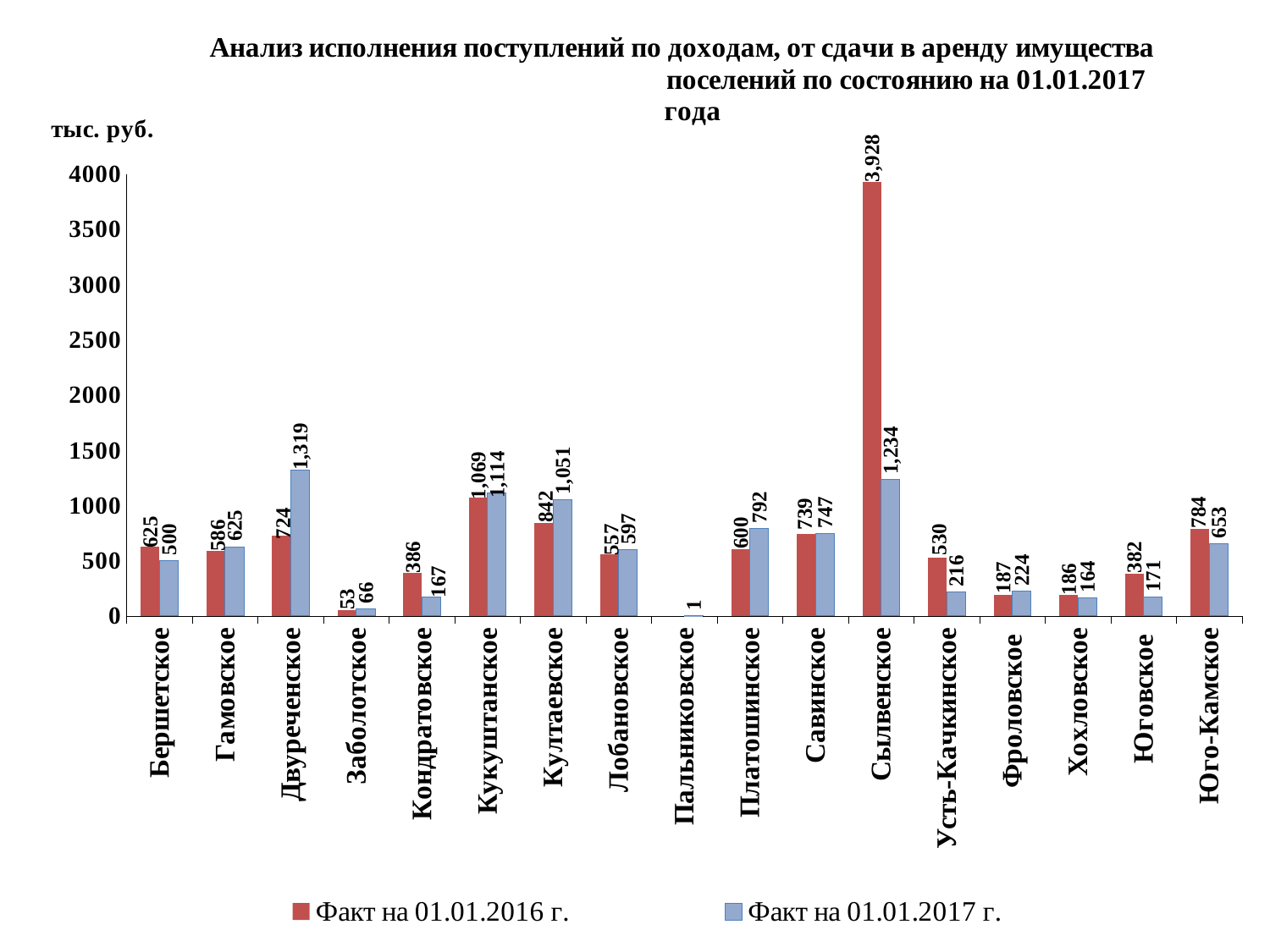
What is the value for Двуреченское in the series Факт на 01.01.2017 г.? 1,319 What kind of chart is shown on the slide? bar chart What is the value for Кондратовское in the series Факт на 01.01.2016 г.? 386 What is the difference between the Факт на 01.01.2016 г. and Факт на 01.01.2017 г. values for Сылвенское? 2,694 Which category has the highest value in the series Факт на 01.01.2016 г.? Сылвенское For Усть-Качкинское, which series has the larger value: Факт на 01.01.2016 г. or Факт на 01.01.2017 г.? Факт на 01.01.2016 г. Which category has the lowest value in the series Факт на 01.01.2017 г. among those with a printed label other than Пальниковское? Заболотское How many categories are shown on the x axis? 17 Is the value for Култаевское in the series Факт на 01.01.2017 г. greater or less than 1000? greater What is the difference between the Факт на 01.01.2017 г. and Факт на 01.01.2016 г. values for Двуреченское? 595 How many series does the legend list? 2 What is the value for Сылвенское in the series Факт на 01.01.2016 г.? 3,928